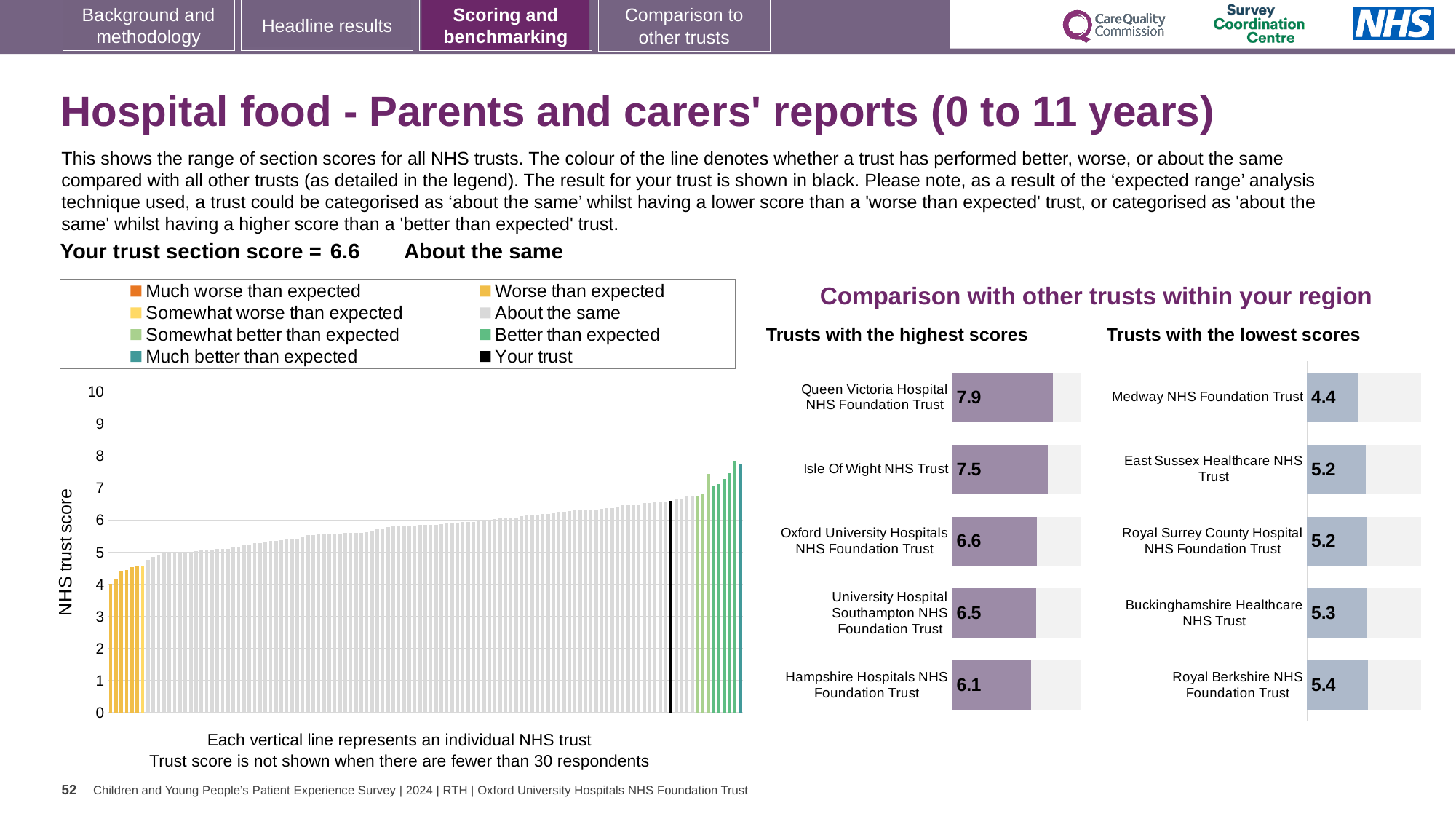
In the large 'NHS trust score' chart on the left, do the bar heights rise or fall from left to right? Rise In the 'Trusts with the highest scores' chart, what is the score for Queen Victoria Hospital NHS Foundation Trust? 7.9 In the 'Trusts with the lowest scores' chart, what is the score for Medway NHS Foundation Trust? 4.4 How many entries does the legend above the large 'NHS trust score' chart list? 8 In the 'Trusts with the lowest scores' chart, which trust has the lowest score? Medway NHS Foundation Trust In the 'Trusts with the lowest scores' chart, how much higher is Royal Berkshire NHS Foundation Trust's score than Medway NHS Foundation Trust's? 1.0 In the 'Trusts with the highest scores' chart, which trust has the highest score? Queen Victoria Hospital NHS Foundation Trust How many trusts are listed in the 'Trusts with the highest scores' chart? 5 What kind of chart is the large 'NHS trust score' chart on the left of the slide? Bar chart In the 'Trusts with the highest scores' chart, which has the larger score: Hampshire Hospitals NHS Foundation Trust or University Hospital Southampton NHS Foundation Trust? University Hospital Southampton NHS Foundation Trust In the 'Trusts with the highest scores' chart, what is the difference between the scores of Queen Victoria Hospital NHS Foundation Trust and Isle Of Wight NHS Trust? 0.4 In the large 'NHS trust score' chart on the left, is the tallest bar greater or less than 7? greater